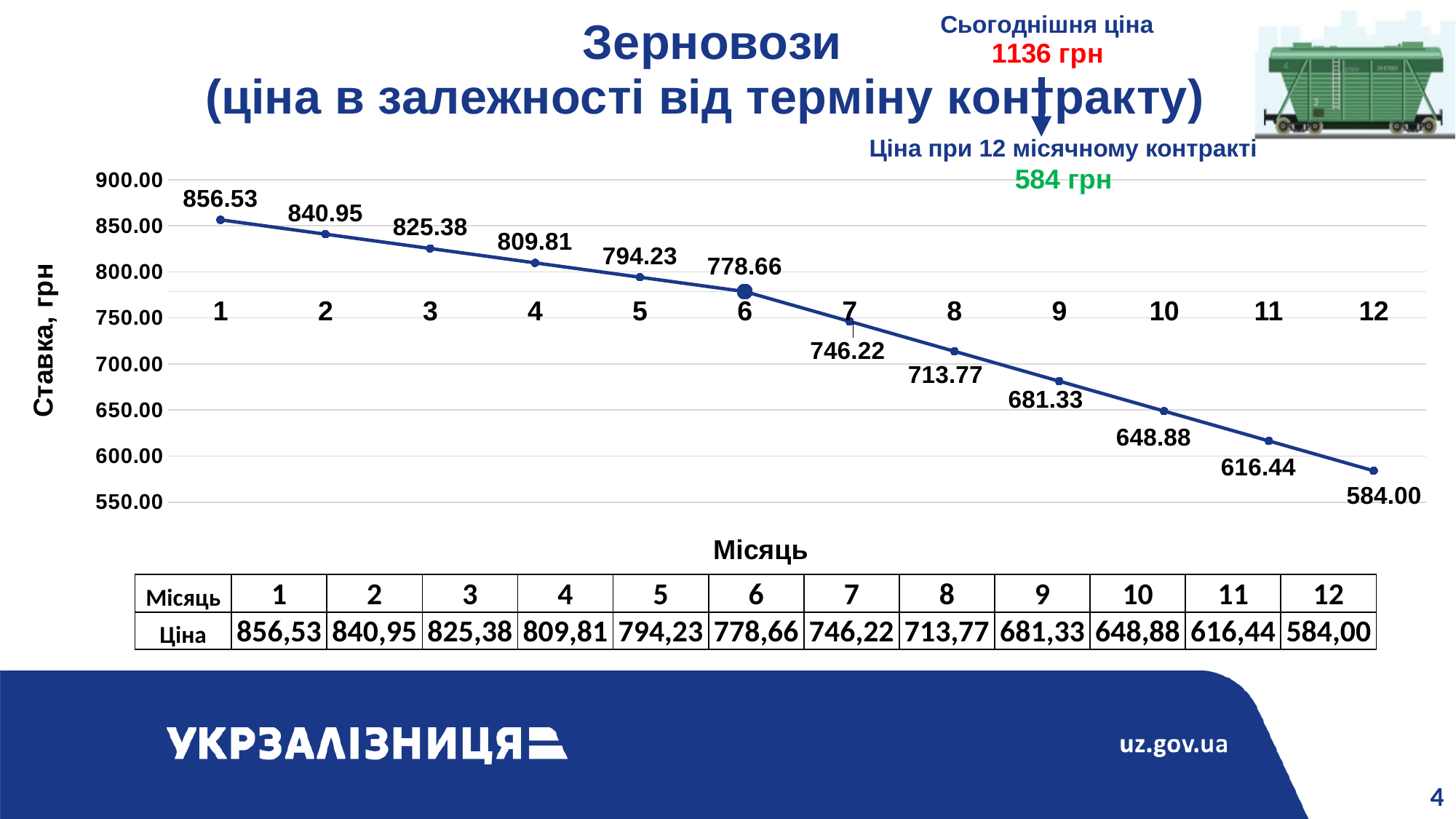
Do the values rise or fall as the month number increases along the x axis? fall How many data points are plotted on the chart? 12 Which is larger, the value for month 4 or the value for month 9? month 4 What is the value for month 1 on the chart? 856.53 What kind of chart is shown on the slide? line chart What is the value for month 7 on the chart? 746.22 Which month has the lowest value on the chart? 12 Which month has the highest value on the chart? 1 What is the difference between the values for month 6 and month 7? 32.44 What is the value for month 12 on the chart? 584.00 What is the difference between the values for month 1 and month 12? 272.53 Is the value for month 10 greater or less than 650.00? less